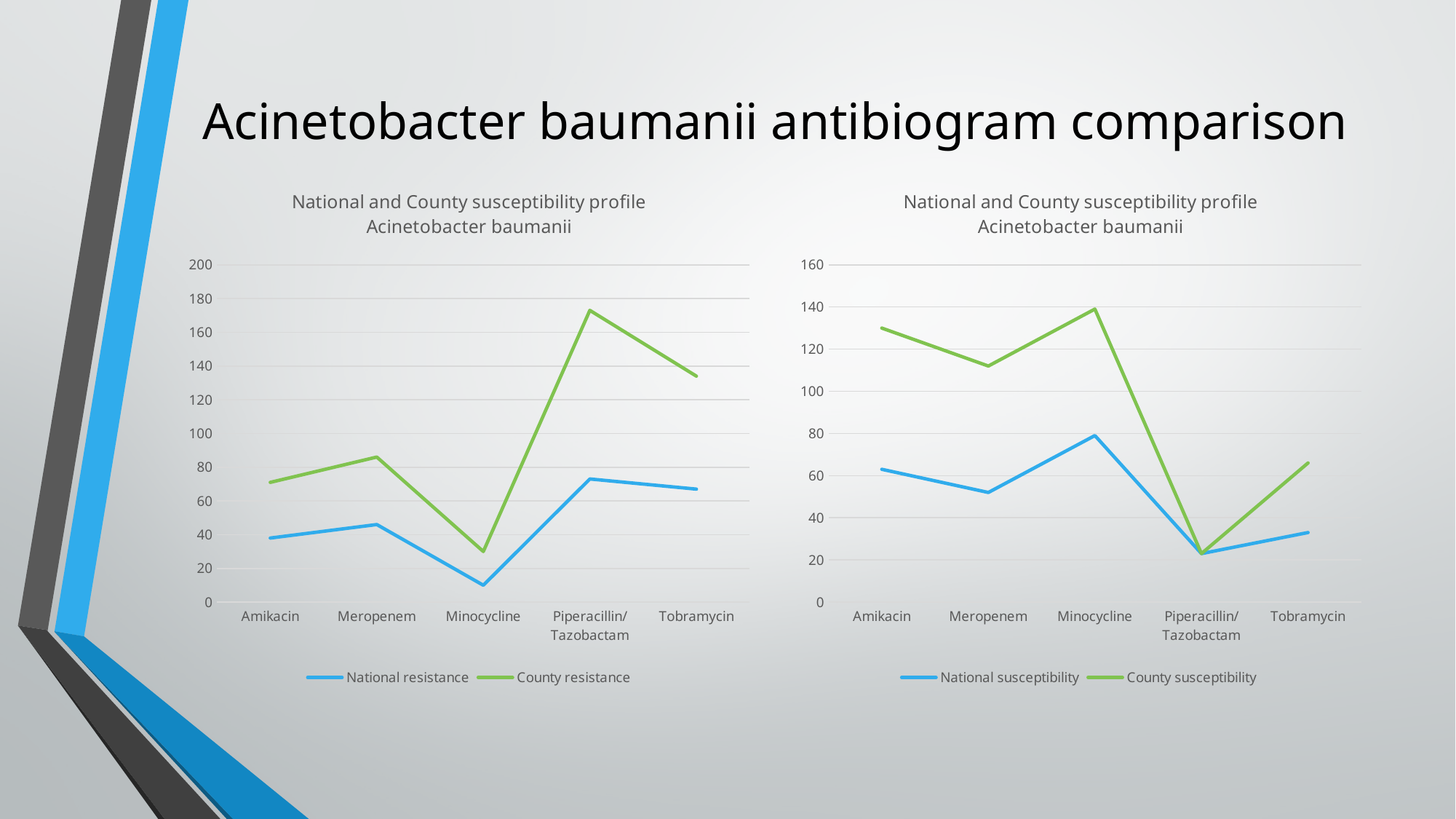
In the right chart, which antibiotic has the lowest National susceptibility value? Piperacillin/Tazobactam In the left chart, is the County resistance value for Piperacillin/Tazobactam greater or less than 160? greater In the left chart, is the National resistance value for Minocycline greater or less than 20? less In the left chart, which antibiotic has the lowest National resistance value? Minocycline In the right chart, is the County susceptibility value for Amikacin greater or less than 120? greater In the left chart, which antibiotic has the highest County resistance value? Piperacillin/Tazobactam In the right chart, does the County susceptibility line rise or fall from Minocycline to Piperacillin/Tazobactam? fall What kind of chart is the left chart on the slide? line chart In the right chart, which is larger for Tobramycin: National susceptibility or County susceptibility? County susceptibility In the right chart, which antibiotic has the highest County susceptibility value? Minocycline How many antibiotics are shown on the x axis of the left chart? 5 How many series does the legend of the right chart list? 2